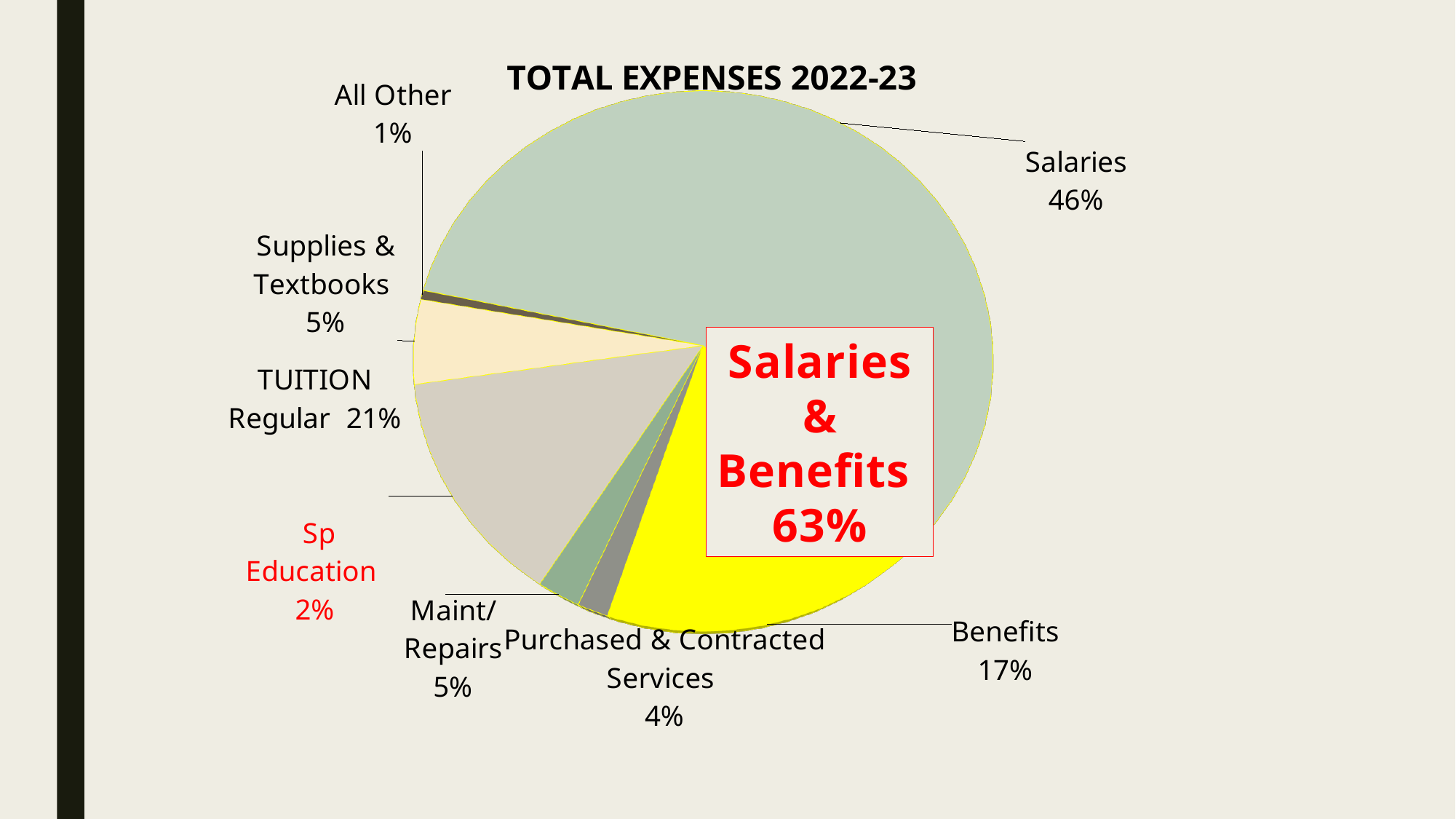
What kind of chart is shown on the slide? Pie chart Which is larger, TUITION Regular or Benefits? TUITION Regular What is the title of the chart? TOTAL EXPENSES 2022-23 What share of total expenses is Benefits? 17% How many categories are shown in the pie chart? 8 What share of total expenses is TUITION Regular? 21% What share of total expenses is Sp Education? 2% What share of total expenses is Salaries? 46% What share of total expenses is Purchased & Contracted Services? 4% Which category has the smallest share of total expenses? All Other What is the difference in percentage points between Salaries and Benefits? 29 Which category has the largest share of total expenses? Salaries